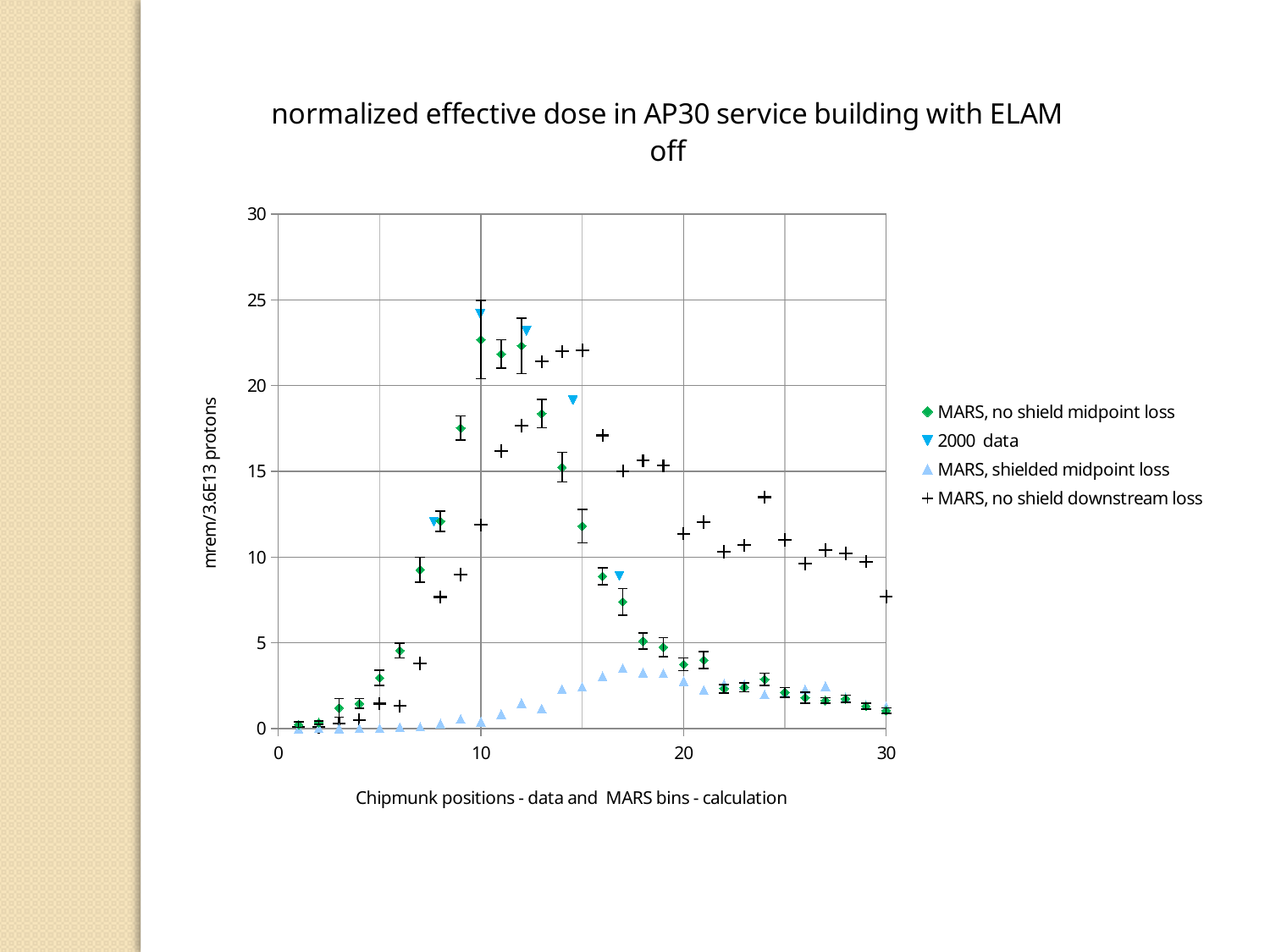
Is the value for the 2000 data series at x = 10 greater or less than 20? greater At x = 25, which is larger: MARS, no shield downstream loss or MARS, no shield midpoint loss? MARS, no shield downstream loss What is the title of the chart? normalized effective dose in AP30 service building with ELAM off What is the label on the y axis? mrem/3.6E13 protons At x = 15, which is larger: the 2000 data value or the MARS, no shield midpoint loss value? 2000 data Is the value for MARS, no shield downstream loss at x = 30 greater or less than 5? greater Is the value for MARS, no shield midpoint loss at x = 7 greater or less than 5? greater Do the MARS, no shield midpoint loss values rise or fall from x = 20 to x = 30? fall How many series does the legend list? 4 What kind of chart is shown on the slide? scatter chart